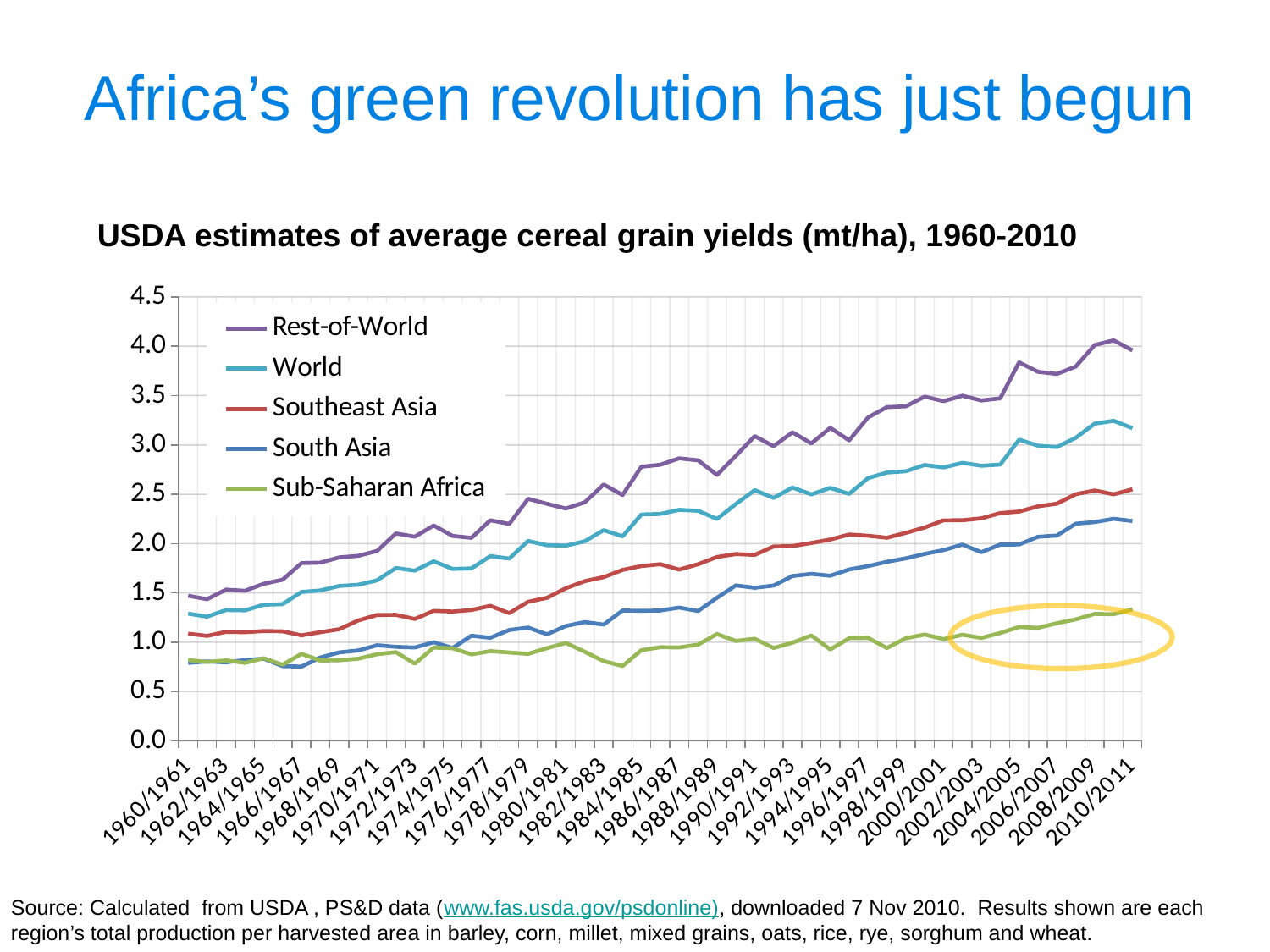
Is the value for South Asia in 2010/2011 greater or less than 2.0? greater What kind of chart is shown on the slide? line chart How many series does the legend list? 5 Is the value for World in 2010/2011 greater or less than 3.0? greater Does the Rest-of-World series generally rise or fall from 1960/1961 to 2010/2011? rise Which series has the highest value in 2010/2011? Rest-of-World Is the value for Rest-of-World in 2010/2011 greater or less than 3.5? greater What is the title of the chart? USDA estimates of average cereal grain yields (mt/ha), 1960-2010 Which series is drawn in green? Sub-Saharan Africa Which series has the lowest value in 2010/2011? Sub-Saharan Africa In 2010/2011, which is larger: South Asia or Sub-Saharan Africa? South Asia